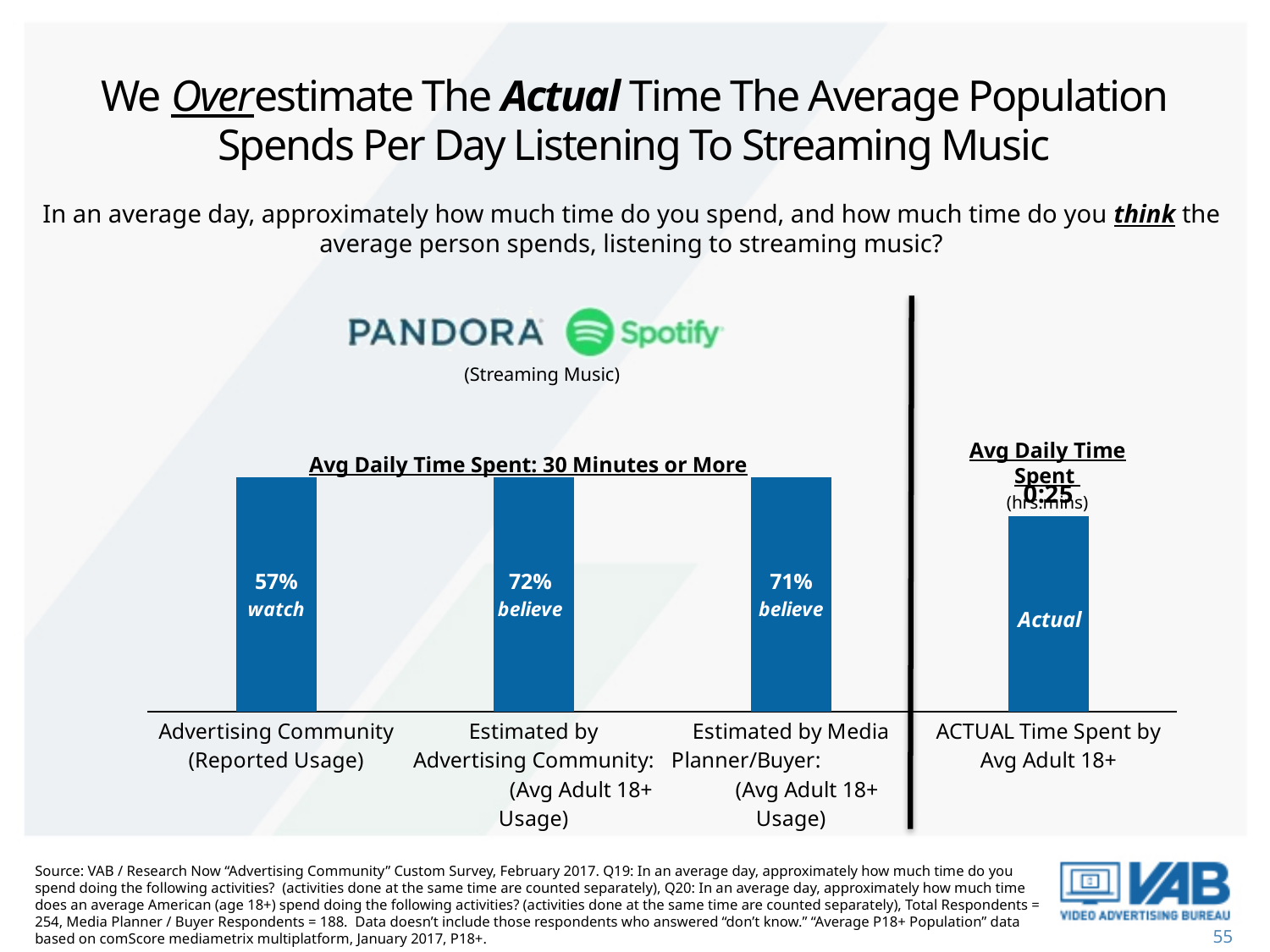
What percentage is shown for the bar labeled 'Estimated by Advertising Community: (Avg Adult 18+ Usage)'? 72% What is the title above the three percentage bars? Avg Daily Time Spent: 30 Minutes or More What percentage is shown for the bar labeled 'Estimated by Media Planner/Buyer: (Avg Adult 18+ Usage)'? 71% Which is larger: the percentage estimated by the Advertising Community or the percentage estimated by Media Planner/Buyer? Estimated by Advertising Community What kind of chart is shown on the slide? Bar chart What percentage of the Advertising Community reported spending 30 minutes or more per day listening to streaming music? 57% What is the difference in percentage points between the Advertising Community's estimate (72%) and its reported usage (57%)? 15 Which category has the lowest percentage among the three percentage bars? Advertising Community (Reported Usage) How many bars are plotted on the chart? 4 What is the ACTUAL average daily time spent by an Avg Adult 18+ listening to streaming music, as shown on the chart? 0:25 Which category has the highest percentage among the three percentage bars? Estimated by Advertising Community: (Avg Adult 18+ Usage) In what units is the 'Avg Daily Time Spent' value for the ACTUAL bar expressed? hrs:mins